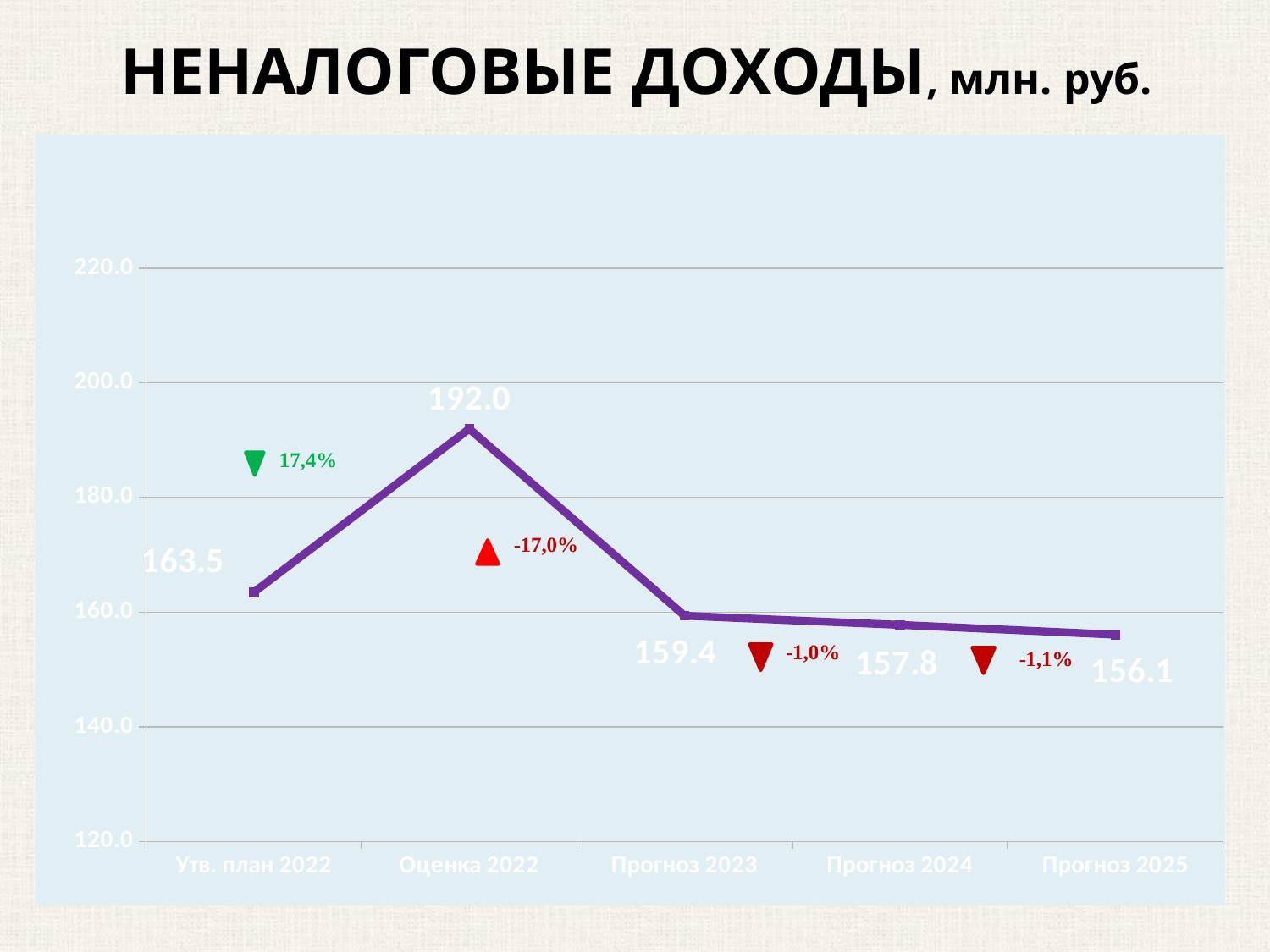
What kind of chart is shown on the slide? line chart How many categories are shown on the x axis? 5 What is the value for Прогноз 2024? 157.8 What is the value for Прогноз 2025? 156.1 Which is larger, the value for Утв. план 2022 or the value for Прогноз 2023? Утв. план 2022 Is the value for Оценка 2022 greater or less than 180.0? greater What is the value for Оценка 2022? 192.0 Which category has the highest value? Оценка 2022 What is the value for Утв. план 2022? 163.5 Which category has the lowest value? Прогноз 2025 What is the difference between the values for Оценка 2022 and Прогноз 2023? 32.6 Do the values rise or fall from Прогноз 2023 to Прогноз 2025? fall